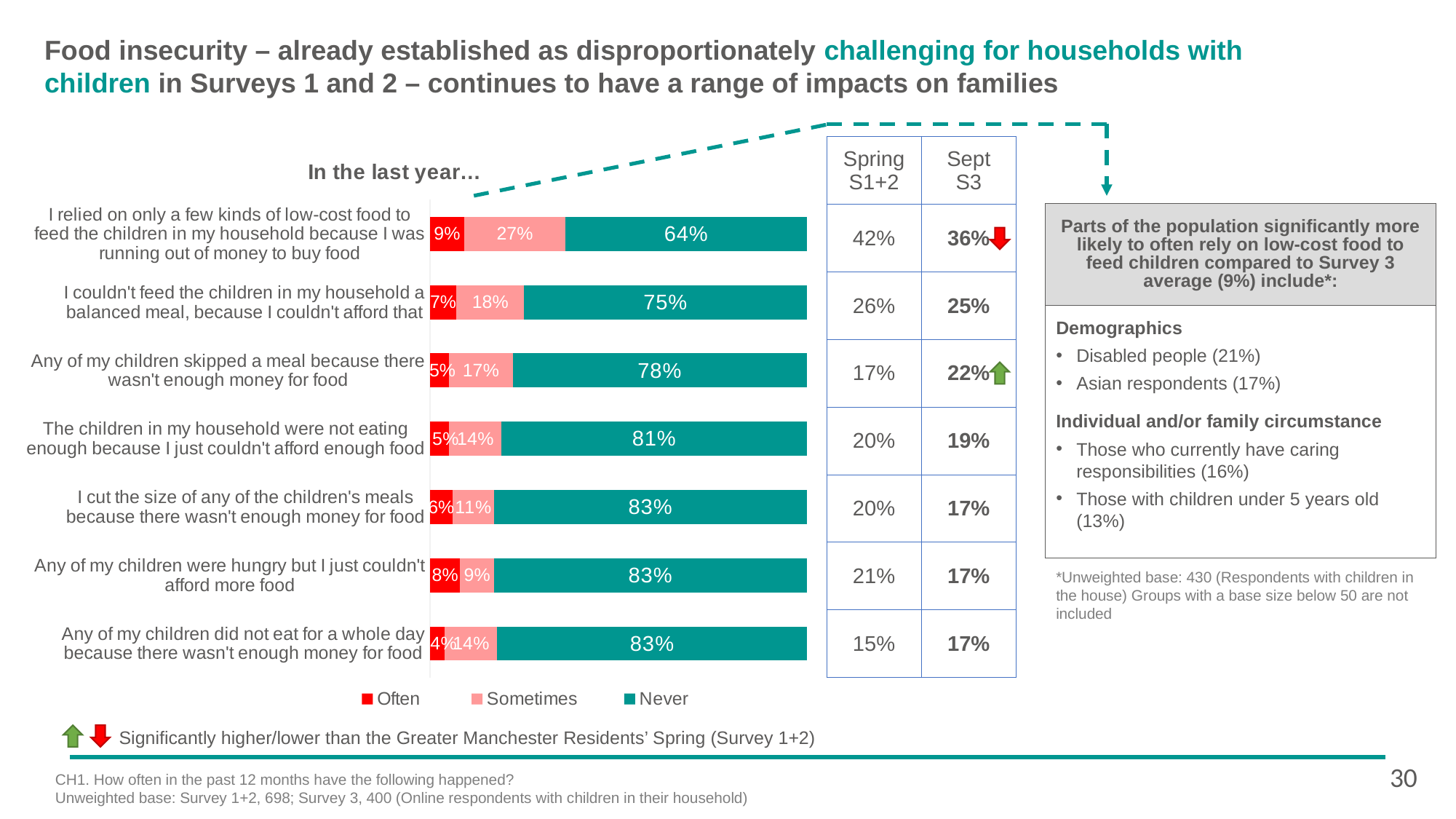
What is the 'Sometimes' value for 'Any of my children skipped a meal because there wasn't enough money for food'? 17% How many statements (categories) are plotted in the chart? 7 What is the total of the stacked bar for 'I relied on only a few kinds of low-cost food to feed the children in my household'? 100% How many series does the chart legend list? 3 Which statement has the highest 'Sometimes' value? I relied on only a few kinds of low-cost food to feed the children in my household because I was running out of money to buy food What is the difference between the 'Never' value for 'The children in my household were not eating enough' and the 'Never' value for 'I relied on only a few kinds of low-cost food'? 17% Which statement has the lowest 'Often' value? Any of my children did not eat for a whole day because there wasn't enough money for food What kind of chart is shown on the slide? Stacked bar chart Which is larger: the 'Often' value for 'Any of my children were hungry but I just couldn't afford more food' or the 'Often' value for 'I cut the size of any of the children's meals'? Any of my children were hungry but I just couldn't afford more food What percentage said they 'Never' couldn't feed the children in their household a balanced meal? 75% What percentage of respondents said they 'Often' relied on only a few kinds of low-cost food to feed the children in their household? 9% What are the three legend entries of the chart? Often, Sometimes, Never